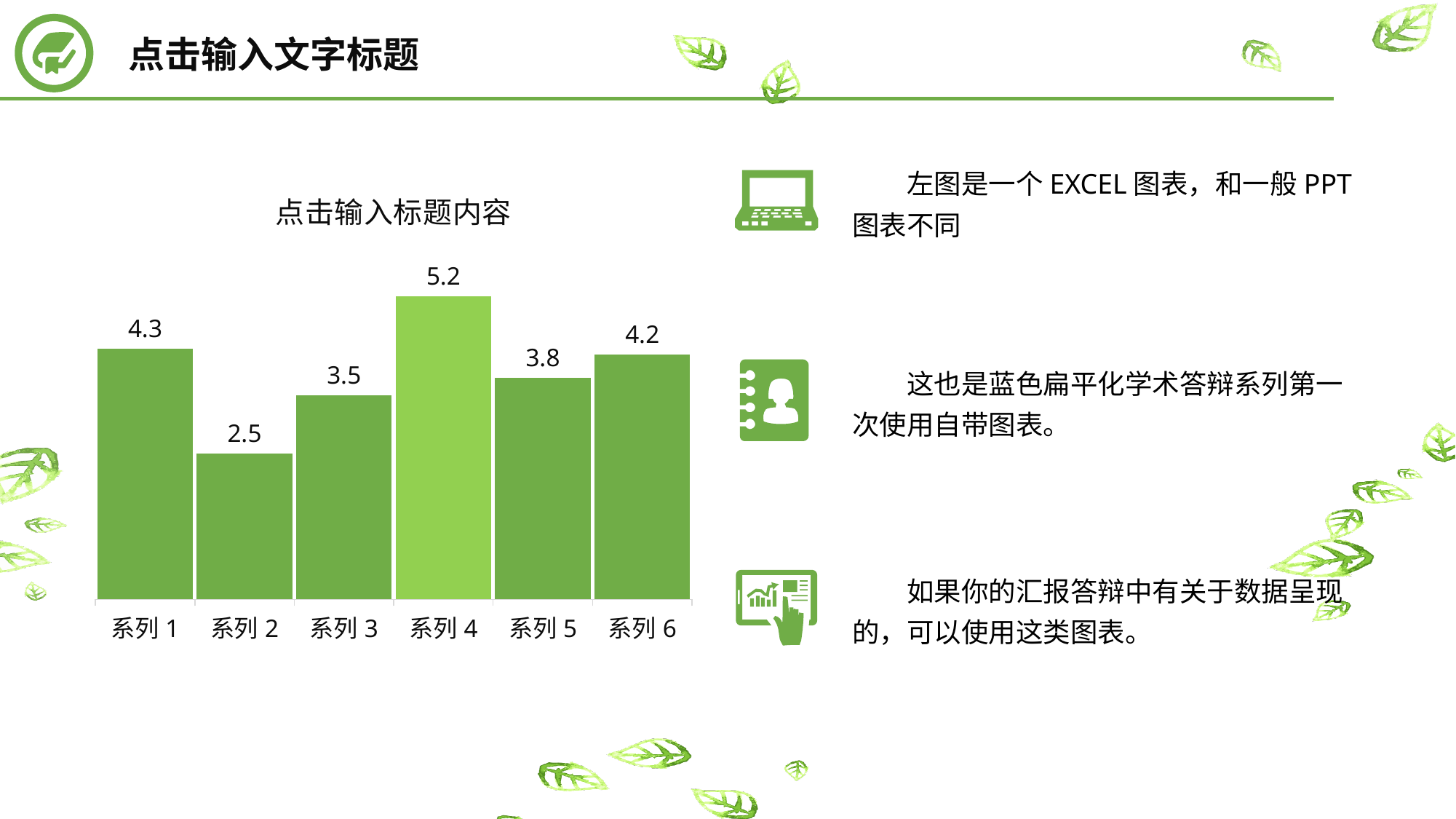
Which bar is shown in a lighter shade of green than the others? 系列 4 How many categories are shown on the chart? 6 What is the value for 系列 2? 2.5 What is the value for 系列 6? 4.2 What is the difference between the values for 系列 4 and 系列 2? 2.7 What is the title of the chart? 点击输入标题内容 What kind of chart is shown on the slide? bar chart Which is larger, the value for 系列 1 or the value for 系列 5? 系列 1 What is the difference between the values for 系列 1 and 系列 3? 0.8 What is the value for 系列 4? 5.2 Which category has the lowest value? 系列 2 Which category has the highest value? 系列 4